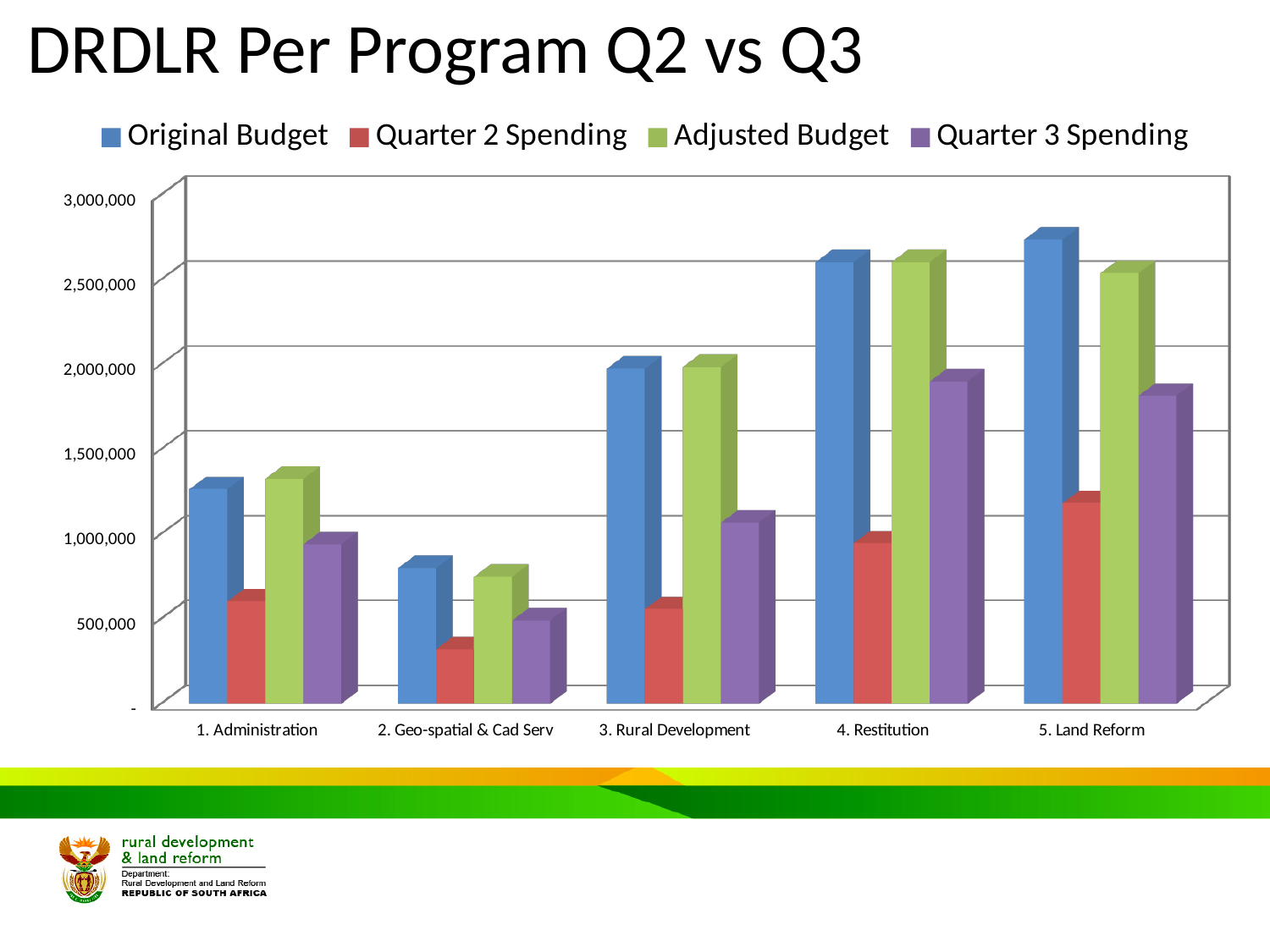
Which program has the lowest Original Budget? 2. Geo-spatial & Cad Serv Which program has the highest Original Budget? 5. Land Reform Is the Quarter 2 Spending for 2. Geo-spatial & Cad Serv greater or less than 500,000? less Which program has the lowest Quarter 2 Spending? 2. Geo-spatial & Cad Serv Is the Original Budget for 5. Land Reform greater or less than 2,500,000? greater Which is larger, the Quarter 2 Spending for 5. Land Reform or for 4. Restitution? 5. Land Reform How many series does the legend list? 4 Is the Quarter 3 Spending for 4. Restitution greater or less than 1,500,000? greater What is the title of the slide's chart? DRDLR Per Program Q2 vs Q3 What kind of chart is shown on the slide? bar chart How many programs are shown on the x axis? 5